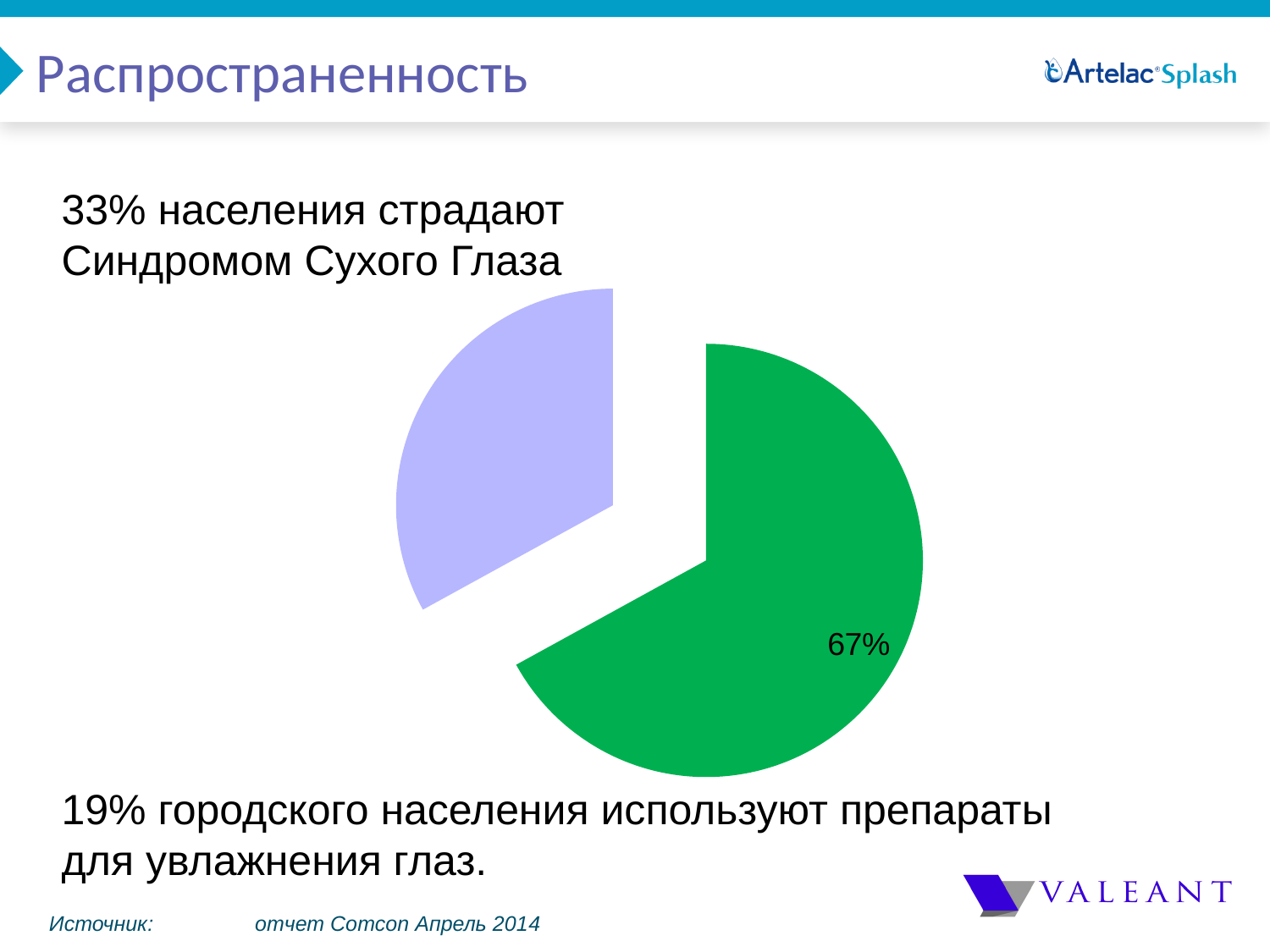
How many slices does the pie chart have? 2 What kind of chart is shown on the slide? pie chart Which slice of the pie chart is pulled out (exploded) from the rest of the pie? the light purple slice Which slice of the pie chart is larger, the green one or the light purple one? the green one Which colour slice is the largest in the pie chart? green Which colour slice is the smallest in the pie chart? light purple What is the title of the slide containing the pie chart? Распространенность Is the green slice of the pie chart greater or less than 50% of the pie? greater Is the light purple slice of the pie chart greater or less than 50% of the pie? less What share of the pie does the green slice represent? 67% What value is printed on the green slice of the pie chart? 67%